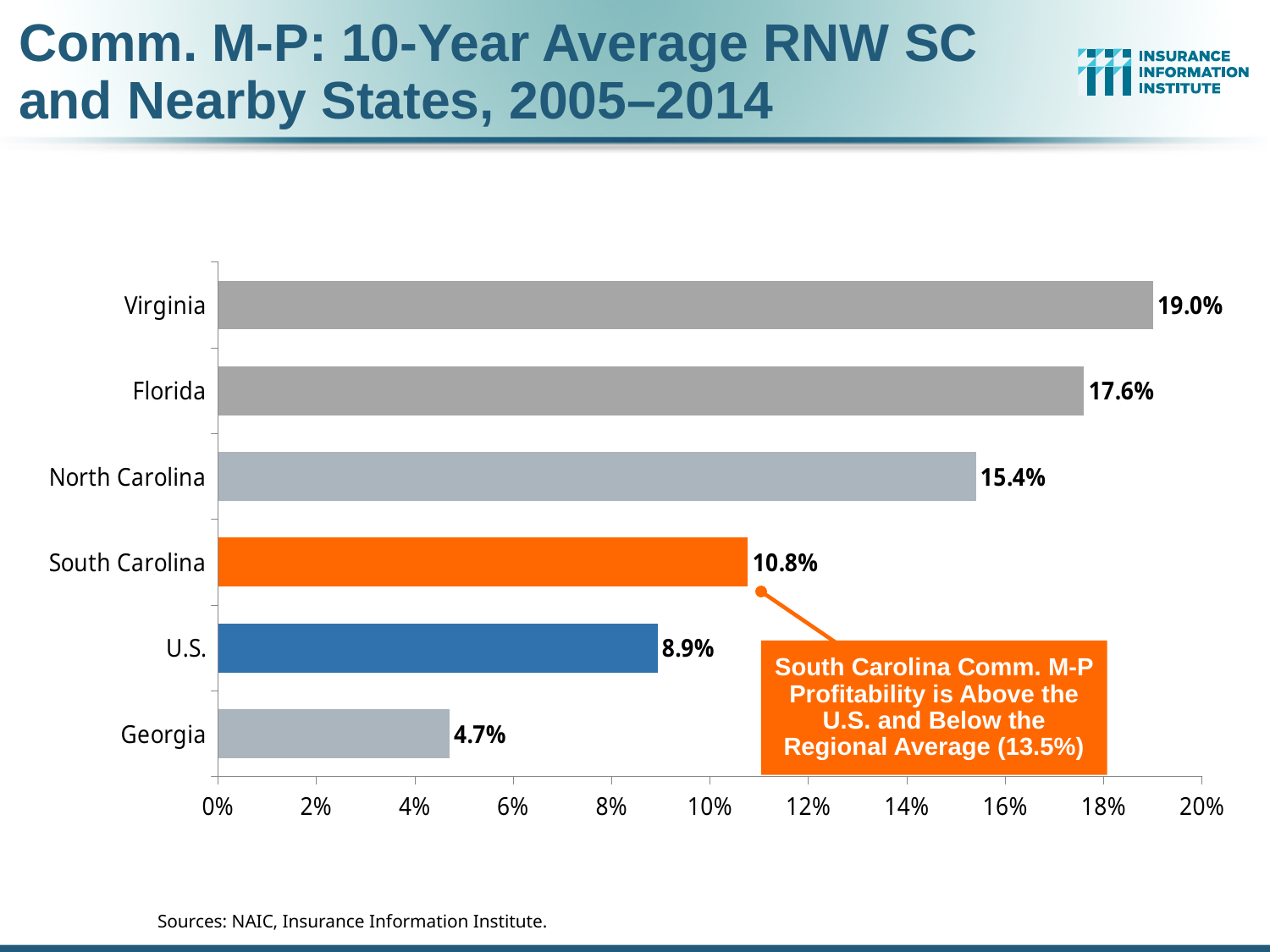
What is the value shown for Virginia? 19.0% Which category has the lowest value on the chart? Georgia Which state has the highest 10-year average RNW on the chart? Virginia What is the value shown for the U.S.? 8.9% How much higher is South Carolina's value than the U.S. value? 1.9% What kind of chart is shown on the slide? Bar chart Is the value for Georgia greater or less than 6%? less What is the 10-year average RNW for South Carolina? 10.8% Which is larger, the value for North Carolina or the value for Florida? Florida What is the difference between Virginia's value and Florida's value? 1.4% How many categories (bars) are shown on the chart? 6 According to the callout box, what is the regional average? 13.5%